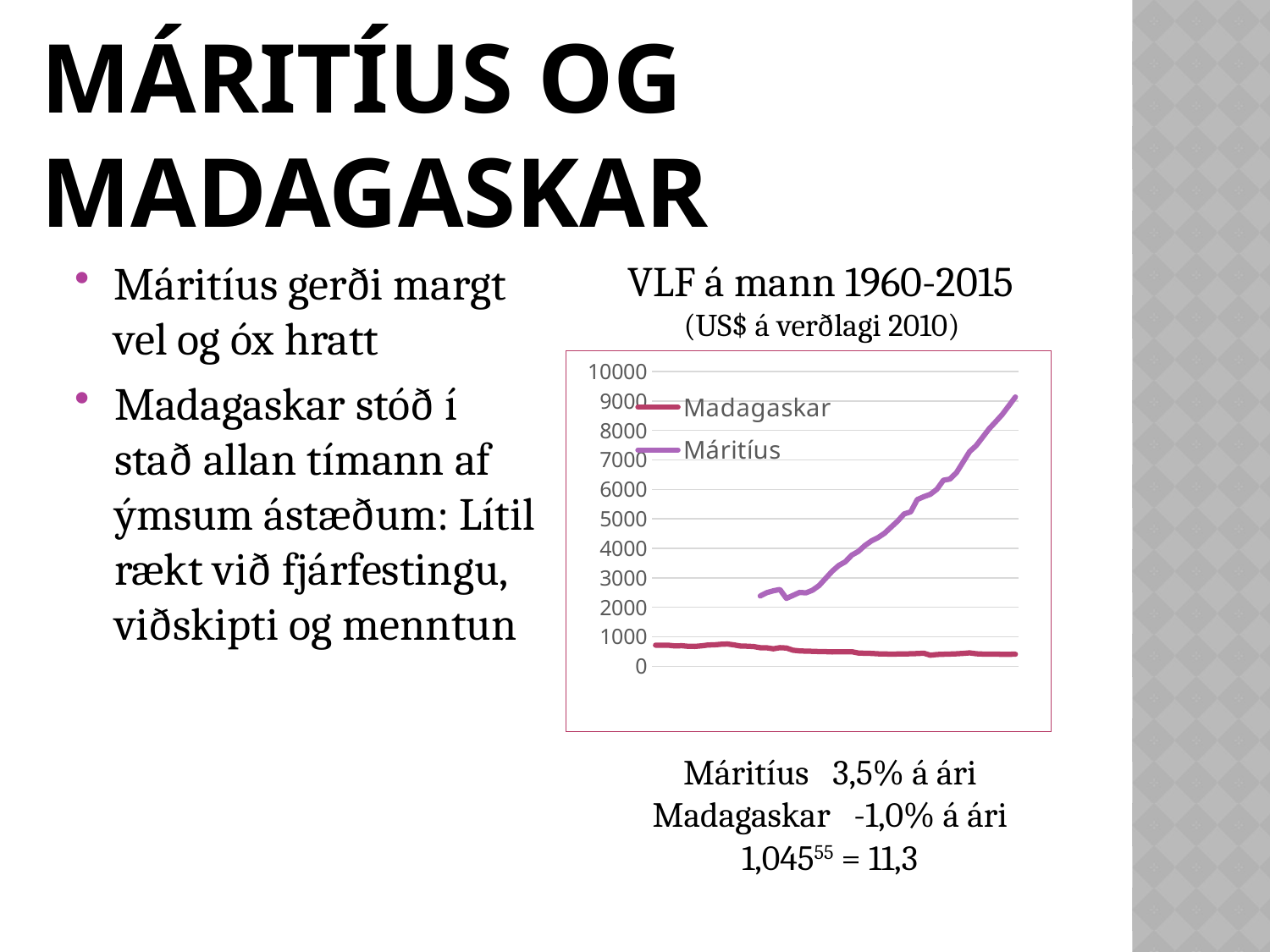
How many series does the chart legend list? 2 Which series has the lowest values on the chart? Madagaskar Is the value of the Madagaskar line at the end of the period greater or less than 1000? less Does the Máritíus line rise or fall over time along the x axis? rise What kind of chart is shown on the slide? line chart Does the Madagaskar line rise or fall over time along the x axis? fall What is the title of the chart? VLF á mann 1960-2015 (US$ á verðlagi 2010) Is the final value of the Máritíus line greater or less than 8000? greater Which series reaches the highest value on the chart? Máritíus Is the starting value of the Máritíus line greater or less than 2000? greater At the right end of the chart, which series has the larger value, Máritíus or Madagaskar? Máritíus Which two series are listed in the chart legend? Madagaskar and Máritíus